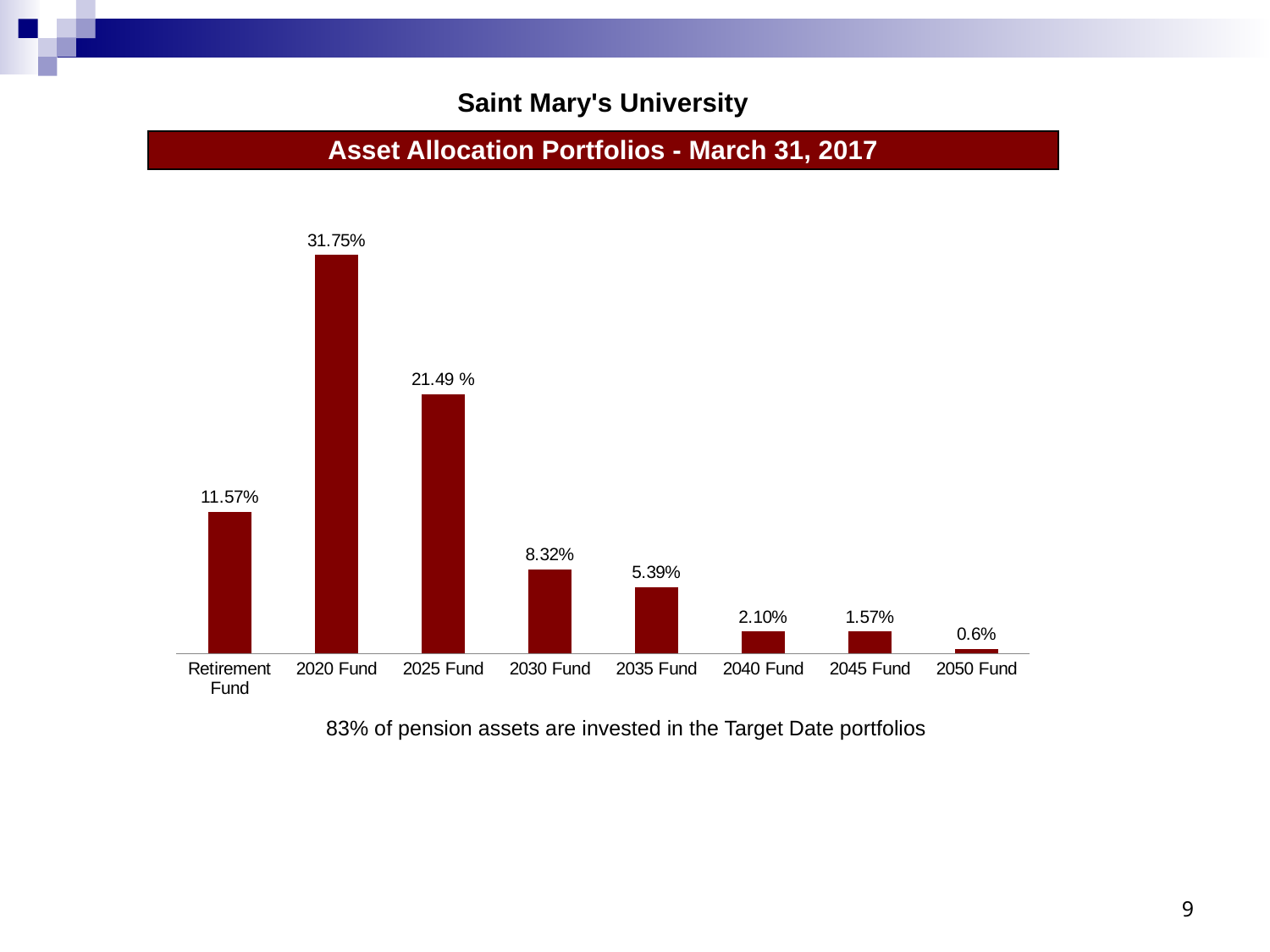
How many funds are shown in the chart? 8 Which is larger, the value for the 2030 Fund or the 2035 Fund? 2030 Fund Which fund has the lowest value? 2050 Fund What is the difference between the 2020 Fund and the 2025 Fund values? 10.26% What is the value for the 2035 Fund? 5.39% Which fund has the highest value? 2020 Fund What is the difference between the Retirement Fund and the 2030 Fund values? 3.25% From the 2020 Fund to the 2050 Fund, do the values rise or fall along the x axis? Fall What kind of chart is shown on the slide? Bar chart What is the value for the Retirement Fund? 11.57% What is the value for the 2050 Fund? 0.6% What is the value for the 2020 Fund? 31.75%